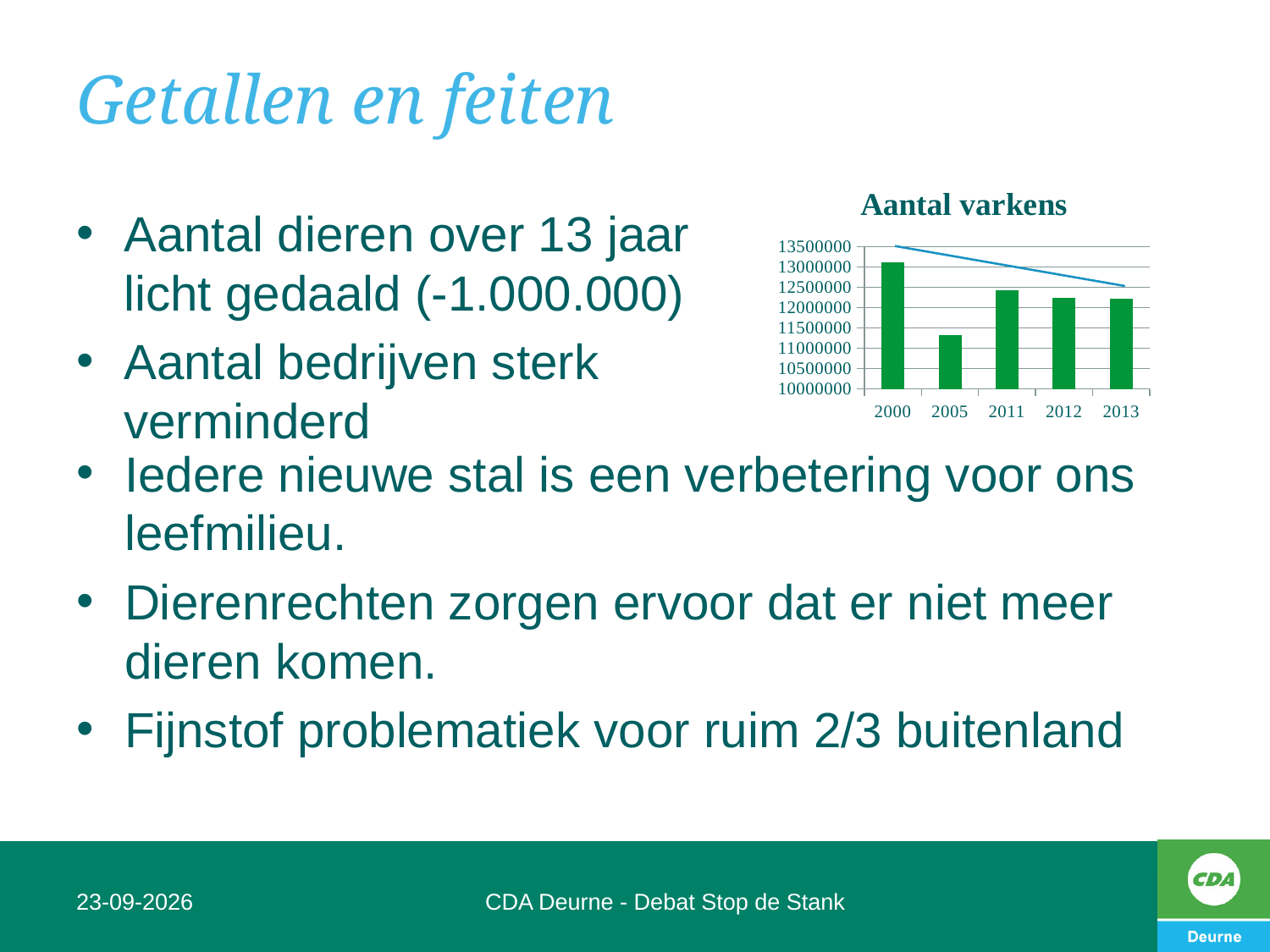
Which year has the lowest bar in the "Aantal varkens" chart? 2005 In the "Aantal varkens" chart, is the value for 2005 greater or less than 11500000? less In the "Aantal varkens" chart, is the value for 2011 greater or less than 12000000? greater In the "Aantal varkens" chart, which year has the larger value, 2013 or 2005? 2013 Does the straight line drawn across the "Aantal varkens" chart rise or fall from 2000 to 2013? fall In the "Aantal varkens" chart, is the value for 2013 greater or less than 12500000? less What kind of chart is shown under the title "Aantal varkens"? bar chart How many years are shown on the x axis of the "Aantal varkens" chart? 5 Which year has the highest bar in the "Aantal varkens" chart? 2000 In the "Aantal varkens" chart, which year has the larger value, 2000 or 2005? 2000 What is the title of the chart on the slide? Aantal varkens